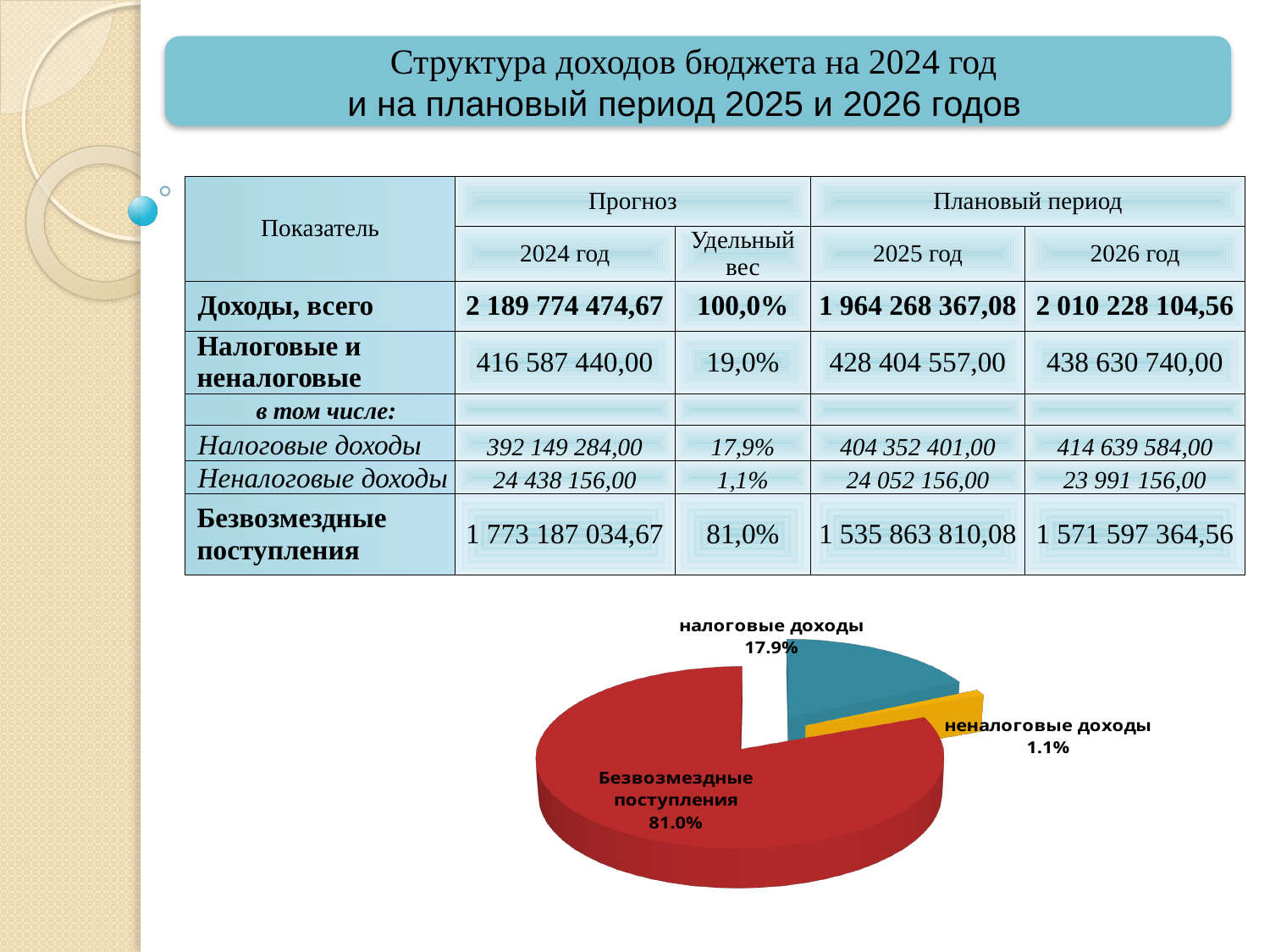
What colour is the Безвозмездные поступления slice in the pie chart? red How many slices does the pie chart have? 3 In the pie chart, which is larger: налоговые доходы or неналоговые доходы? налоговые доходы Which slice of the pie chart is the smallest? неналоговые доходы In the pie chart, what is the difference in percentage points between налоговые доходы and неналоговые доходы? 16.8 What share of the pie chart is labelled for неналоговые доходы? 1.1% In the pie chart, what is the difference in percentage points between Безвозмездные поступления and налоговые доходы? 63.1 What share of the pie chart is labelled for Безвозмездные поступления? 81.0% What colour is the налоговые доходы slice in the pie chart? teal What share of the pie chart is labelled for налоговые доходы? 17.9% What kind of chart is shown on the slide? pie chart Which slice of the pie chart is the largest? Безвозмездные поступления